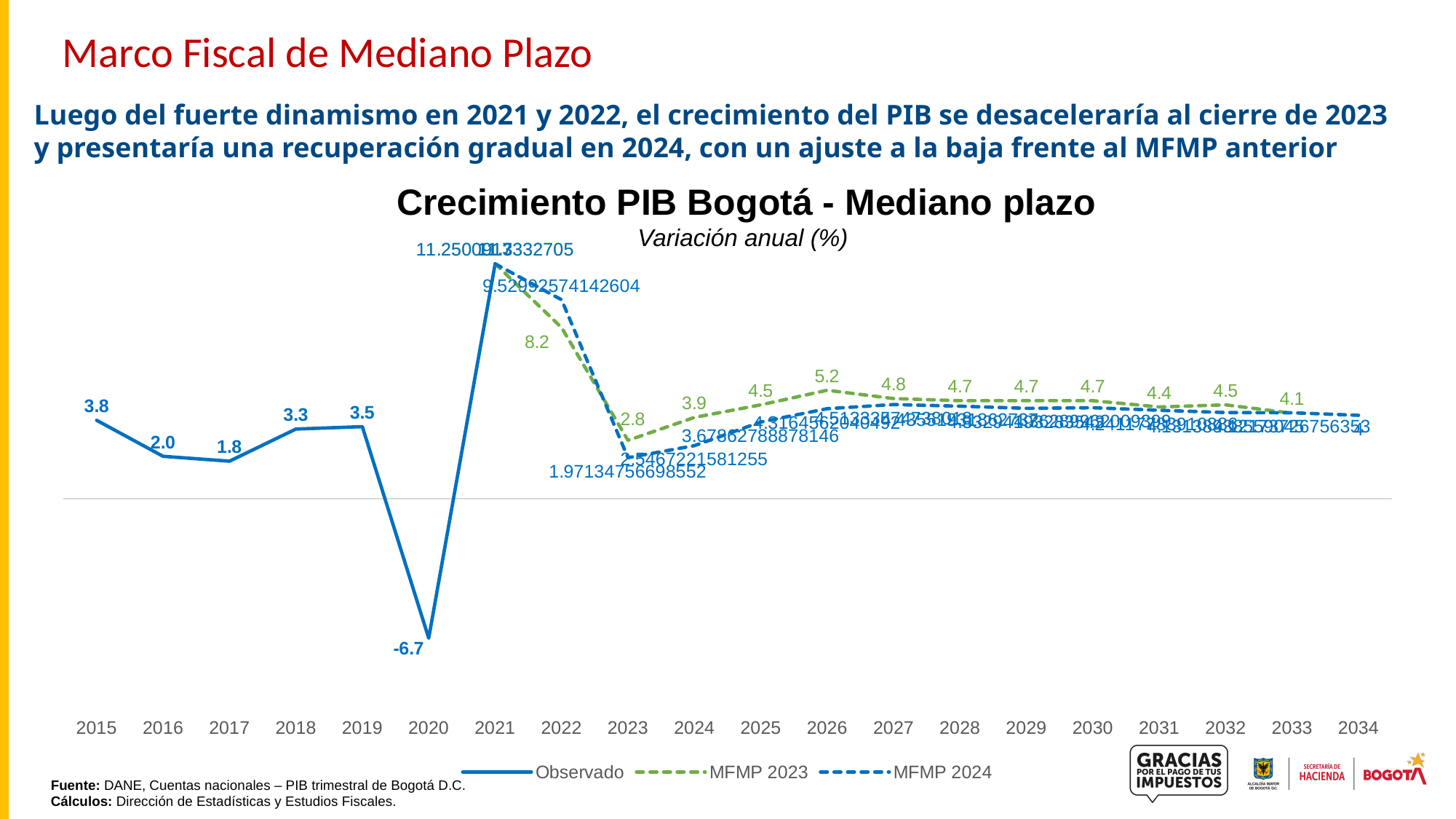
What is the Observado value for 2020? -6.7 What is the difference between the MFMP 2023 values for 2026 and 2033? 1.1 How many series does the legend list? 3 In which year between 2024 and 2034 does the MFMP 2023 series reach its highest value? 2026 Which year has the larger Observado value, 2015 or 2016? 2015 What is the difference between the Observado values for 2019 and 2018? 0.2 What kind of chart is shown on the slide? Line chart What is the Observado value for 2015? 3.8 In which year does the Observado series reach its lowest value? 2020 What is the MFMP 2023 value for 2022? 8.2 What is the MFMP 2023 value for 2026? 5.2 What is the Observado value for 2017? 1.8